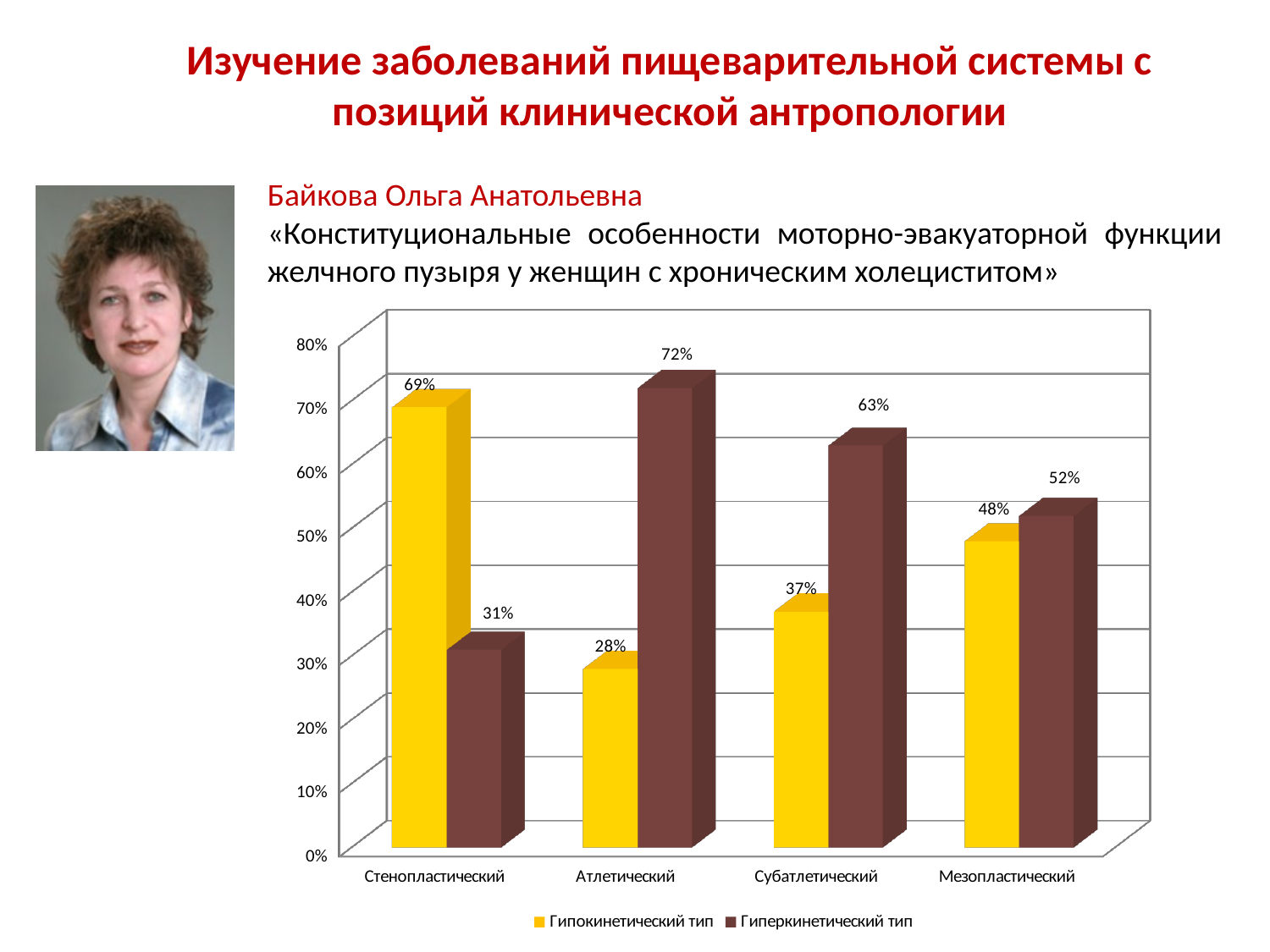
What is the value for Гиперкинетический тип in the Атлетический category? 72% How many categories are shown on the x axis? 4 Which category has the lowest value for Гипокинетический тип? Атлетический What colour are the bars for Гипокинетический тип? yellow What is the value for Гипокинетический тип in the Стенопластический category? 69% What kind of chart is shown on the slide? bar chart In the Стенопластический category, which series has the larger value, Гипокинетический тип or Гиперкинетический тип? Гипокинетический тип How many series does the legend list? 2 Which category has the highest value for Гиперкинетический тип? Атлетический What is the value for Гипокинетический тип in the Мезопластический category? 48% Is the value for Гиперкинетический тип in the Мезопластический category greater or less than 50%? greater What is the difference between Гипокинетический тип and Гиперкинетический тип in the Субатлетический category? 26%